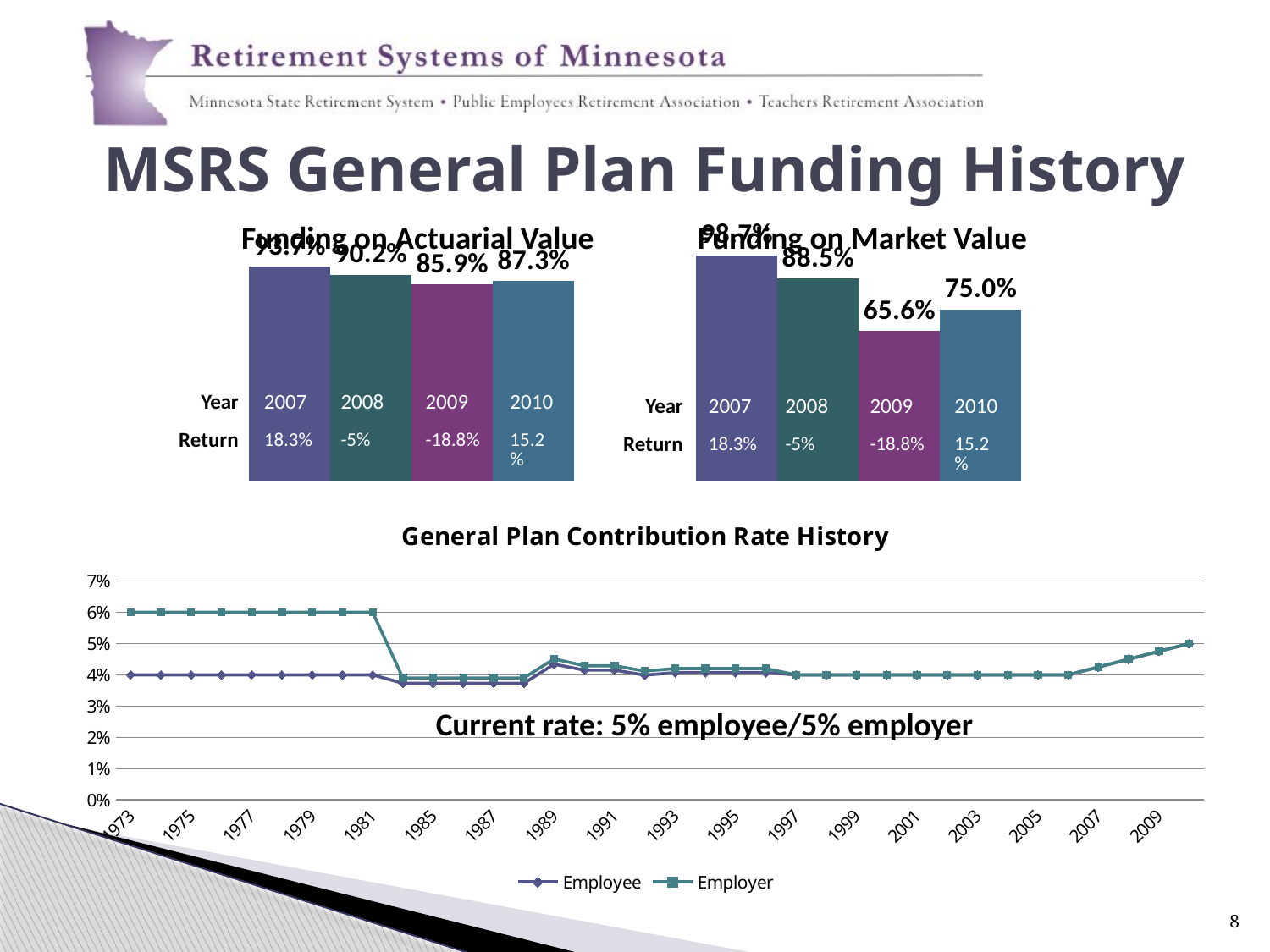
In the Funding on Actuarial Value chart, what is the funding value for 2009? 85.9% In the Funding on Actuarial Value chart, what is the funding value for 2010? 87.3% In the Funding on Market Value chart, what is the difference between the 2008 and 2010 funding values? 13.5 percentage points In the Funding on Market Value chart, which is larger, the 2009 value or the 2010 value? 2010 In the General Plan Contribution Rate History chart, is the Employer rate in 1975 greater or less than 5%? greater In the Funding on Actuarial Value chart, what is the difference between the 2008 and 2009 funding values? 4.3 percentage points In the Funding on Actuarial Value chart, what is the Return shown for 2009? -18.8% In the Funding on Market Value chart, what is the funding value for 2010? 75.0% What kind of chart is the General Plan Contribution Rate History? Line chart In the Funding on Market Value chart, which year has the lowest funding value? 2009 How many series does the legend of the General Plan Contribution Rate History chart list? 2 In the Funding on Market Value chart, what is the funding value for 2009? 65.6%